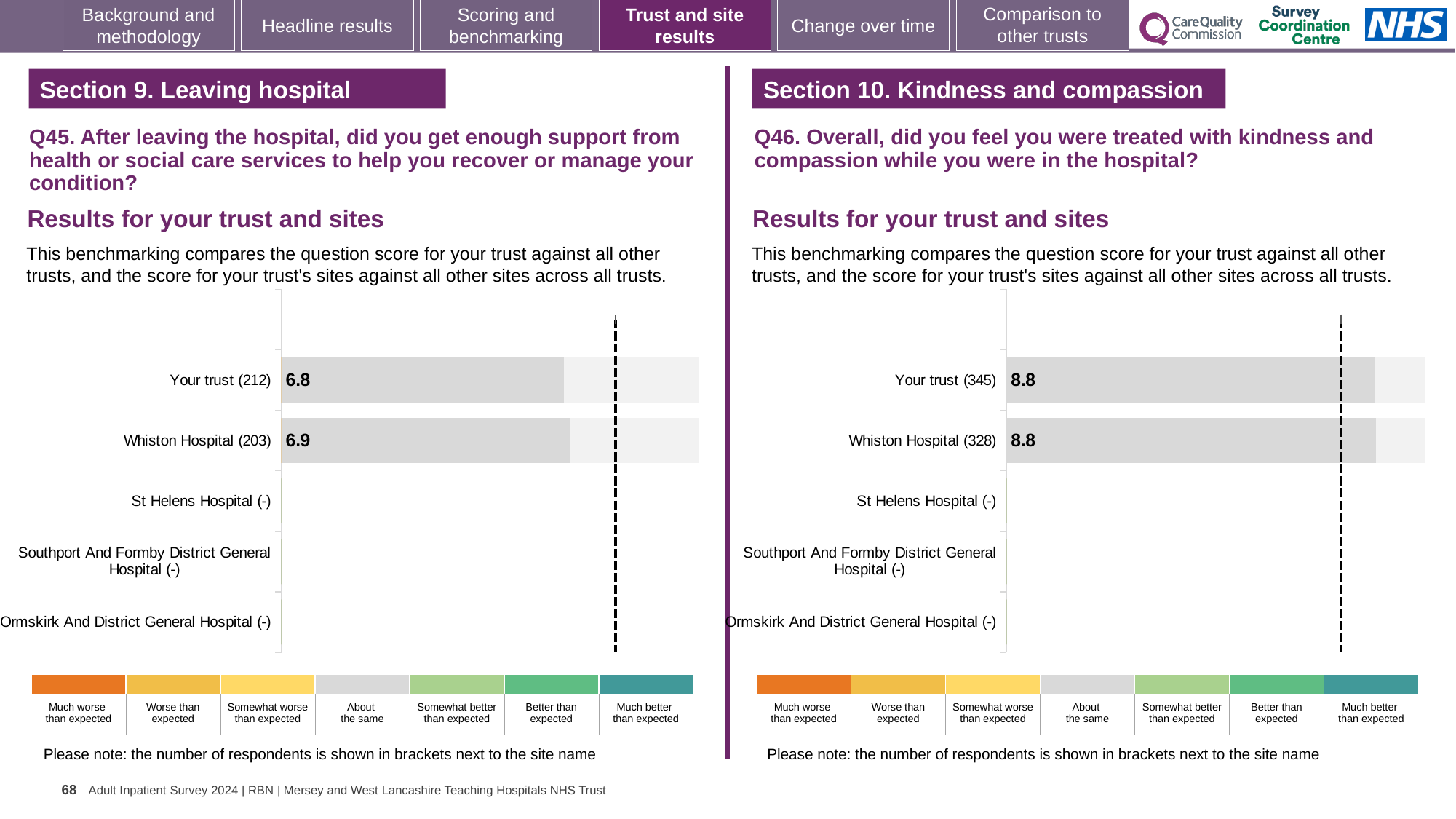
How many rating bands are shown in the colour key below the Q46 chart on the right? 7 In the Q46 chart on the right, what is the score for Whiston Hospital? 8.8 In the Q45 chart on the left, what is the difference between the Whiston Hospital score and the Your trust score? 0.1 In the Q45 chart on the left, what is the score for Your trust? 6.8 In the Q45 chart on the left, how many respondents are shown in brackets for Whiston Hospital? 203 What kind of chart is the Q45 chart on the left? Bar chart How many site/trust categories are listed on the y axis of the Q46 chart on the right? 5 In the Q45 chart on the left, how many categories have a plotted bar with a score? 2 In the Q46 chart on the right, how many respondents are shown in brackets for Your trust? 345 In the Q45 chart on the left, what is the score for Whiston Hospital? 6.9 In the Q46 chart on the right, what is the score for Your trust? 8.8 In the Q45 chart on the left, which has the higher score, Your trust or Whiston Hospital? Whiston Hospital